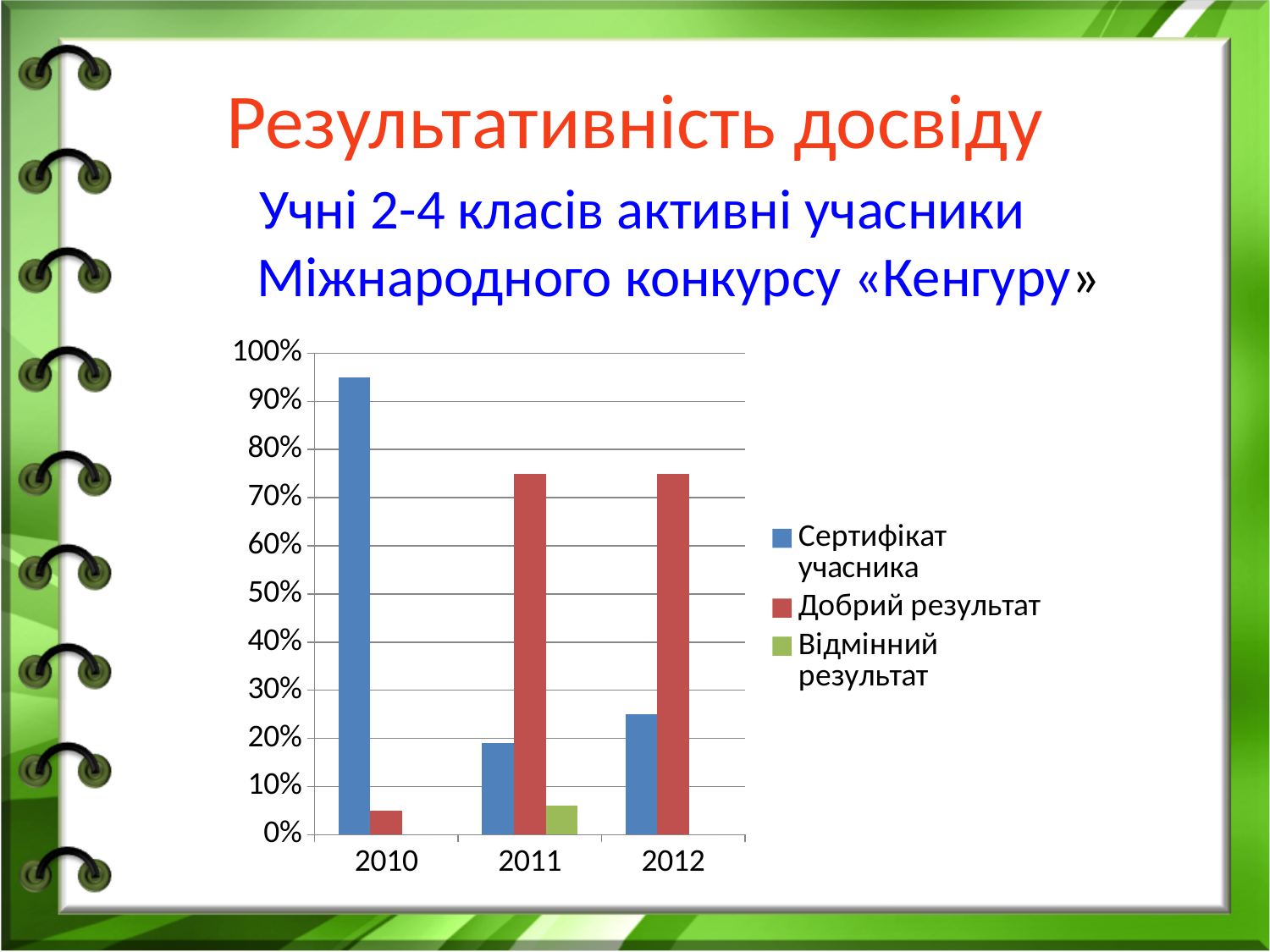
Which year has the highest value for Сертифікат учасника? 2010 What kind of chart is shown on the slide? bar chart Which year has the lowest value for Добрий результат? 2010 Does the value for Добрий результат rise or fall from 2010 to 2011? rise How many series does the chart legend list? 3 Is the value for Сертифікат учасника in 2010 greater or less than 90%? greater Which colour represents Відмінний результат in the chart legend? green Is the value for Добрий результат in 2011 greater or less than 70%? greater How many years are shown on the x axis of the chart? 3 Which year has the lowest value for Сертифікат учасника? 2011 Which is larger in 2012: Сертифікат учасника or Добрий результат? Добрий результат Is the value for Відмінний результат in 2011 greater or less than 10%? less